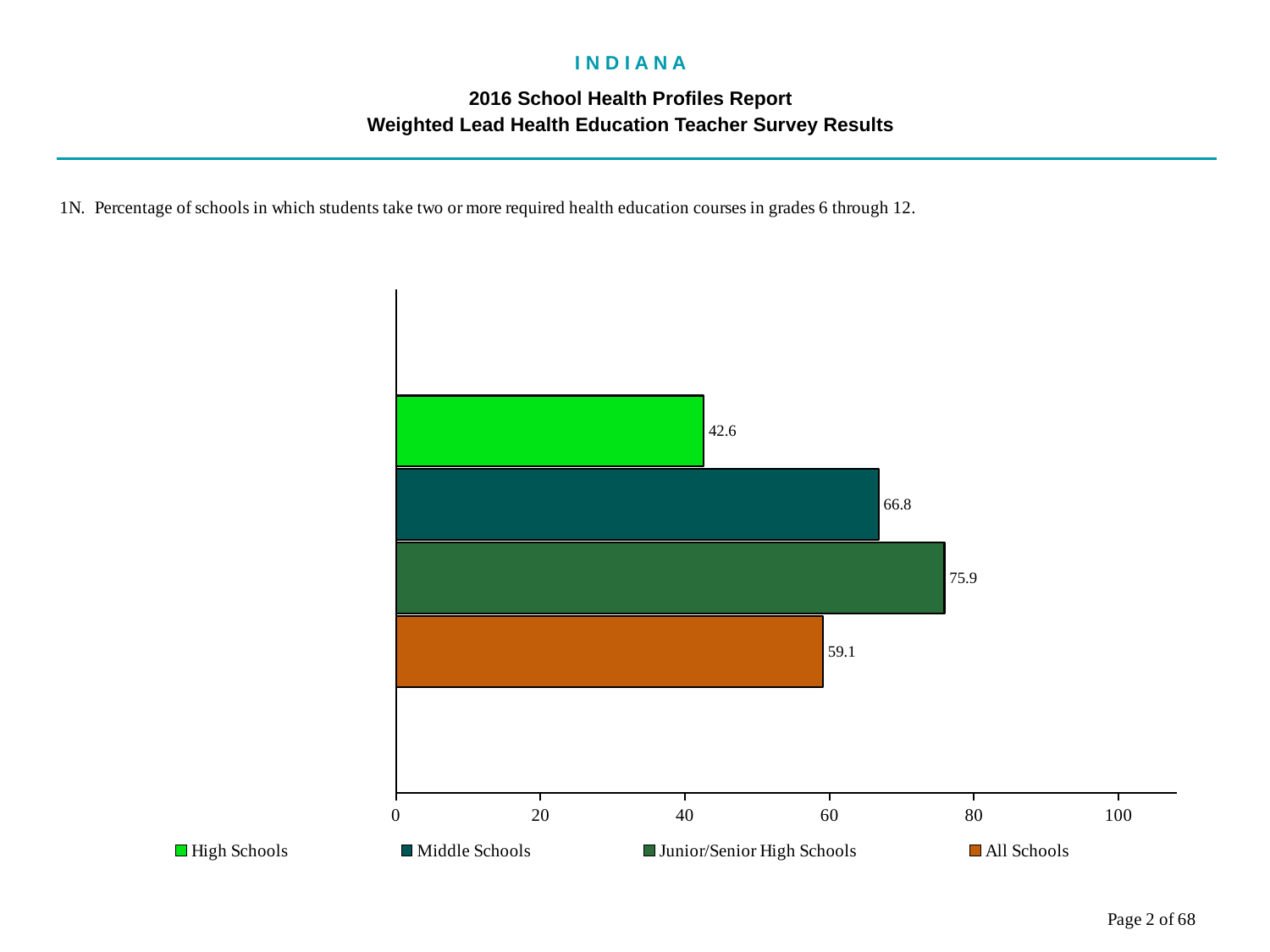
What is the difference between the values for Junior/Senior High Schools and High Schools? 33.3 How many bars are shown in the chart? 4 What colour is the bar for All Schools? orange Which is larger, the value for Middle Schools or the value for All Schools? Middle Schools What is the value for Junior/Senior High Schools? 75.9 What is the value for All Schools? 59.1 Which school type has the lowest value? High Schools What is the value for Middle Schools? 66.8 Is the value for All Schools greater or less than 60? less What is the value for High Schools? 42.6 Which school type has the highest value? Junior/Senior High Schools What kind of chart is shown on the slide? bar chart